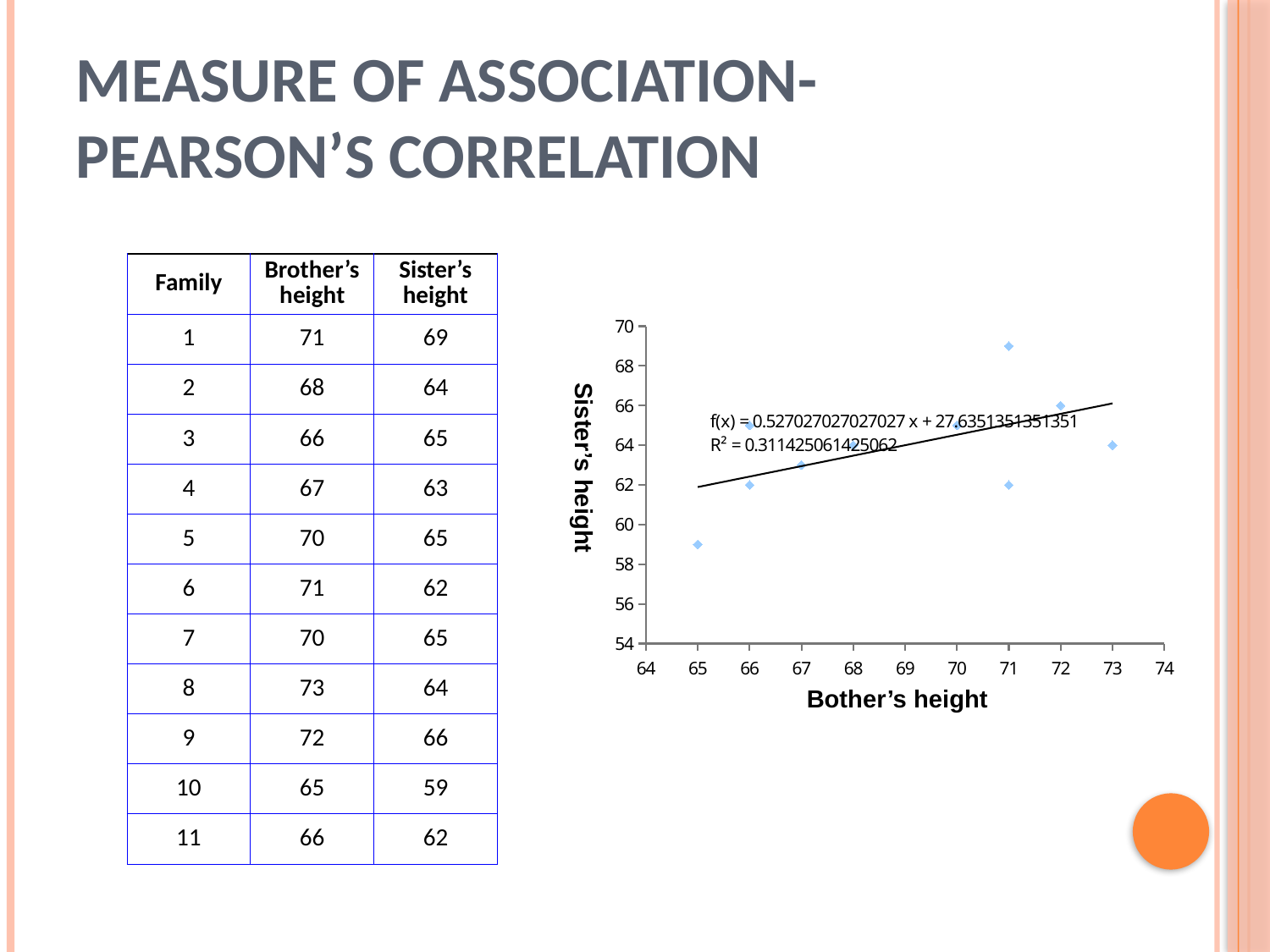
Is the sister's height for the point at brother's height 73 greater or less than 62? greater What R² value is printed on the chart? 0.311425061425062 Is the sister's height for the point at brother's height 65 greater or less than 60? less What is the title of the y axis of the chart? Sister's height Does the trendline on the chart rise or fall as brother's height increases? Rises What is the lowest sister's height plotted on the chart? 59 What kind of chart is shown on the slide? Scatter chart What is the difference between the highest and lowest sister's height plotted on the chart? 10 What is the slope of the trendline equation printed on the chart? 0.527027027027027 What is the largest brother's height at which a point is plotted on the chart? 73 What is the highest sister's height plotted on the chart? 69 What is the title of the x axis of the chart? Bother's height